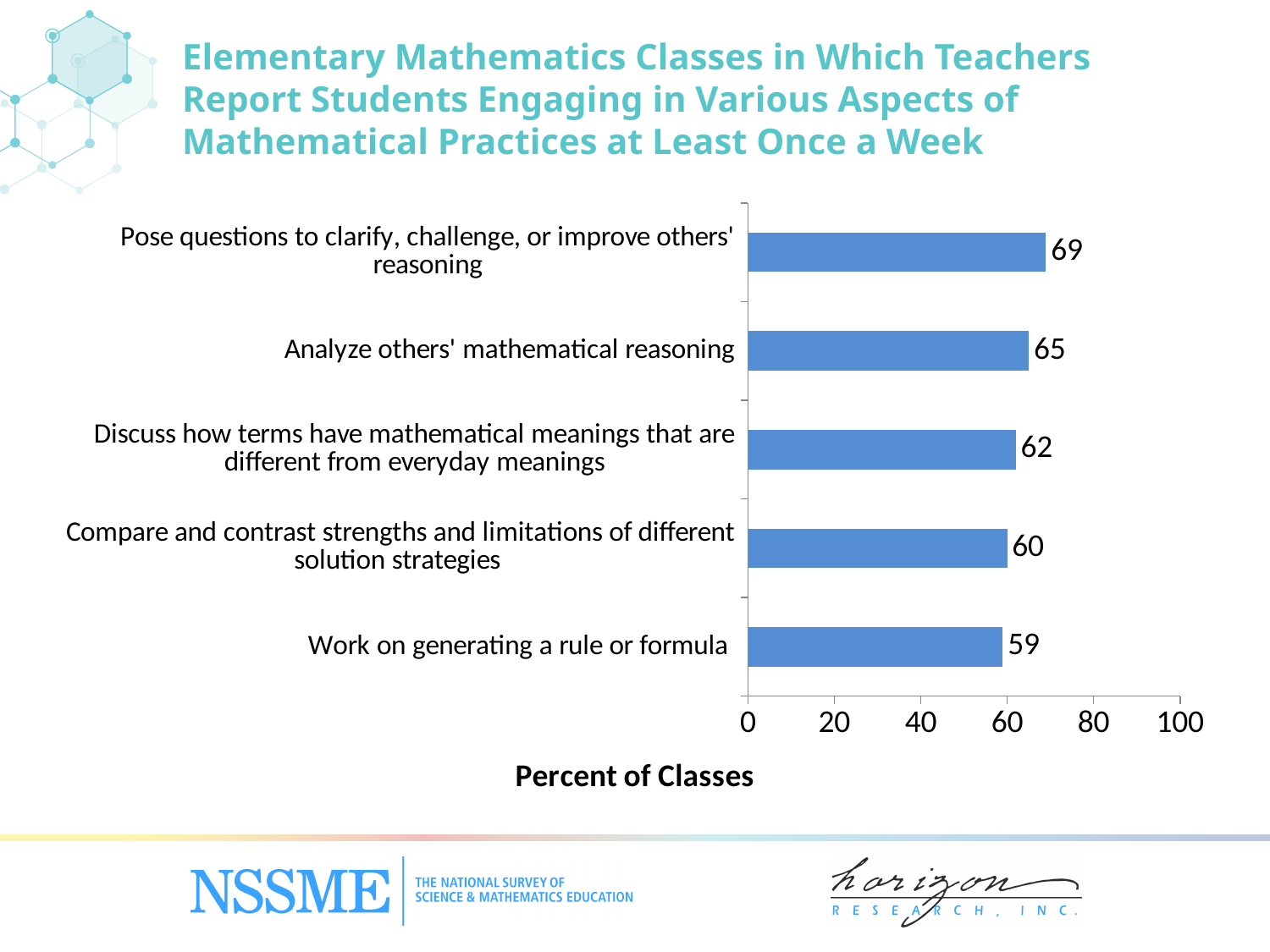
What is the label of the horizontal axis? Percent of Classes What kind of chart is shown on the slide? Bar chart Which is larger: the value for "Analyze others' mathematical reasoning" or the value for "Compare and contrast strengths and limitations of different solution strategies"? Analyze others' mathematical reasoning What percent of classes is reported for "Analyze others' mathematical reasoning"? 65 Which category has the lowest percent of classes? Work on generating a rule or formula What is the value for "Discuss how terms have mathematical meanings that are different from everyday meanings"? 62 What is the maximum value shown on the horizontal axis? 100 Is the value for "Compare and contrast strengths and limitations of different solution strategies" greater or less than 80? less What is the value for "Work on generating a rule or formula"? 59 Which category has the highest percent of classes? Pose questions to clarify, challenge, or improve others' reasoning How many categories are shown in the chart? 5 What is the difference between the values for "Pose questions to clarify, challenge, or improve others' reasoning" and "Work on generating a rule or formula"? 10